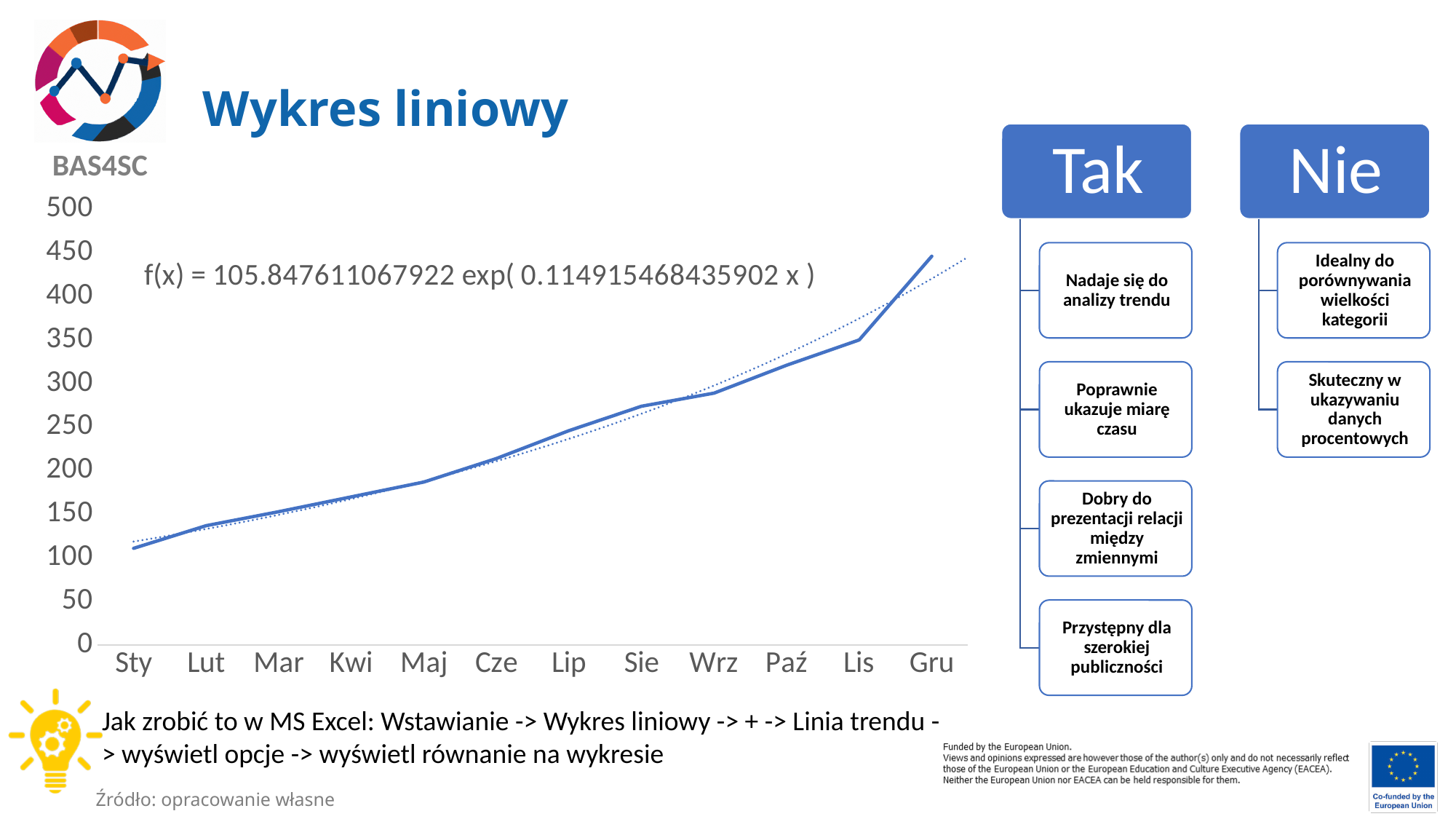
How many months are plotted along the x axis of the chart? 12 Is the value for Sty greater or less than 150? less Is the value for Sie greater or less than 250? greater Which month has the highest value on the chart? Gru What kind of chart is shown on the slide? line chart Is the value for Gru greater or less than 400? greater What is the title of the slide containing the chart? Wykres liniowy What trendline equation is displayed on the chart? f(x) = 105.847611067922 exp( 0.114915468435902 x ) Which month has the larger value, Lip or Mar? Lip Which month has the lowest value on the chart? Sty Do the values rise or fall from Sty to Gru? rise